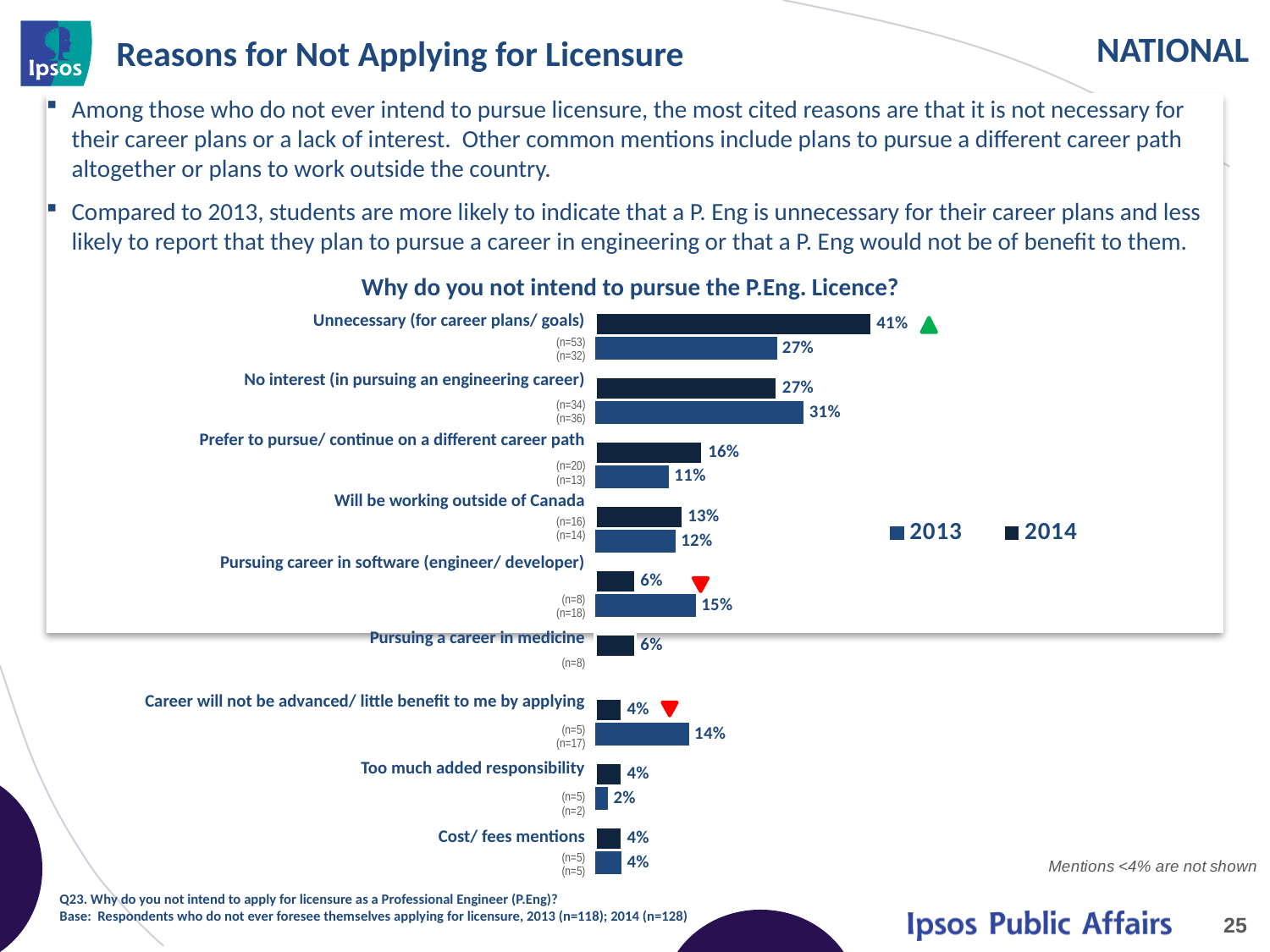
For "No interest (in pursuing an engineering career)", which year has the larger value, 2013 or 2014? 2013 What is the difference between the 2013 and 2014 values for "Career will not be advanced/ little benefit to me by applying"? 10% For "Prefer to pursue/ continue on a different career path", which year has the larger value, 2013 or 2014? 2014 Which reason has the highest 2014 value? Unnecessary (for career plans/ goals) What is the 2013 value for "No interest (in pursuing an engineering career)"? 31% What is the 2013 value for "Pursuing career in software (engineer/ developer)"? 15% How many reasons (categories) are shown in the chart? 9 What is the 2014 value for "Unnecessary (for career plans/ goals)"? 41% What is the difference between the 2014 and 2013 values for "Unnecessary (for career plans/ goals)"? 14% What kind of chart is shown on the slide? Bar chart How many series does the legend list? 2 Which reason has the lowest 2013 value? Too much added responsibility